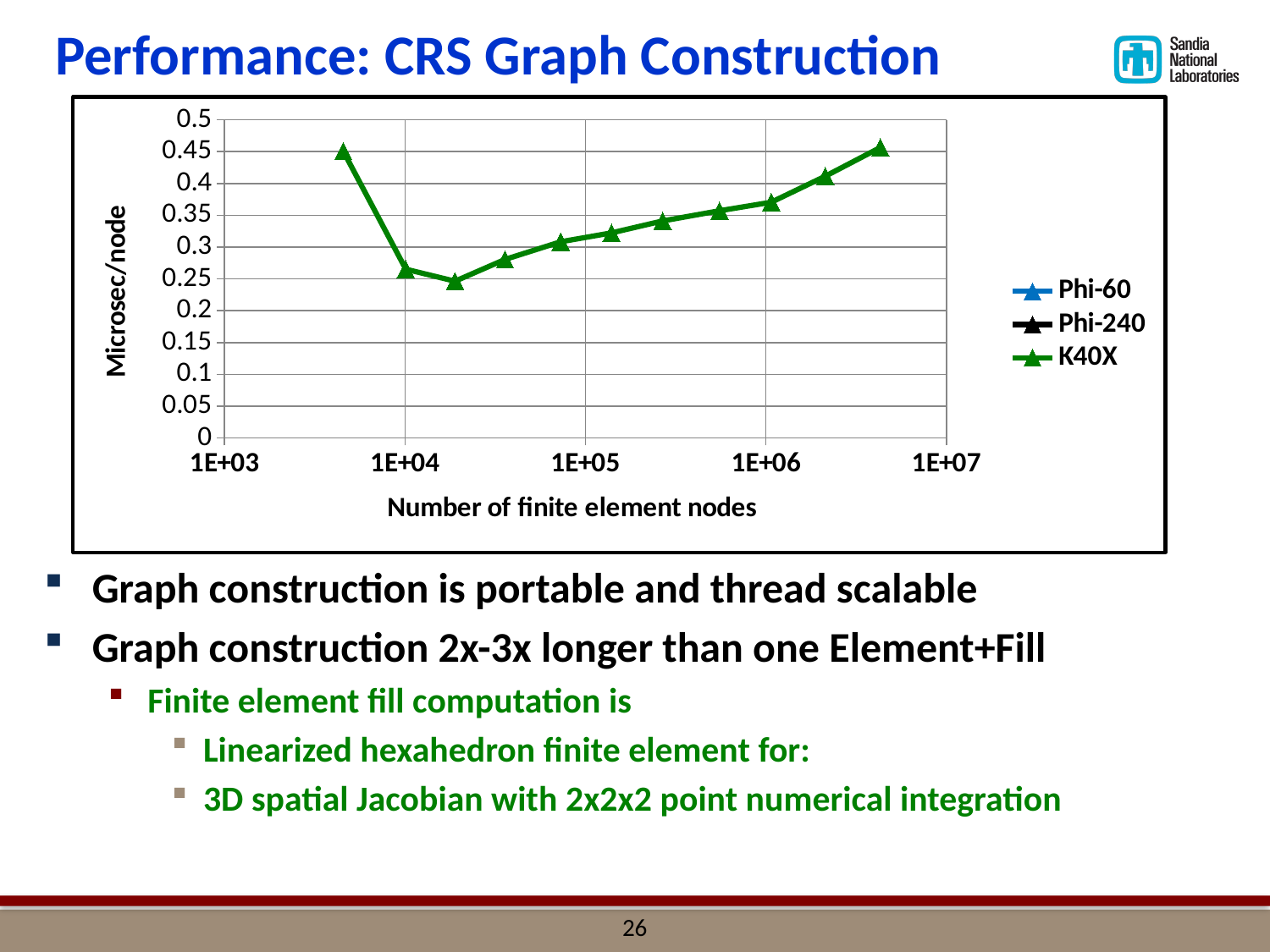
Is the value of the first (leftmost) K40X point greater or less than 0.4? greater After reaching its minimum, do the K40X values rise or fall as the number of finite element nodes increases? rise How many series does the legend list? 3 Which series is visibly plotted on the chart? K40X Is the lowest value on the K40X line greater or less than 0.3? less What is the label of the y axis? Microsec/node Is the value of the last (rightmost) K40X point greater or less than 0.4? greater Which is larger for K40X: the first point or the second point? the first point How many data points are plotted on the K40X line? 11 What kind of chart is shown on the slide? line chart Which series are listed in the legend? Phi-60, Phi-240, K40X